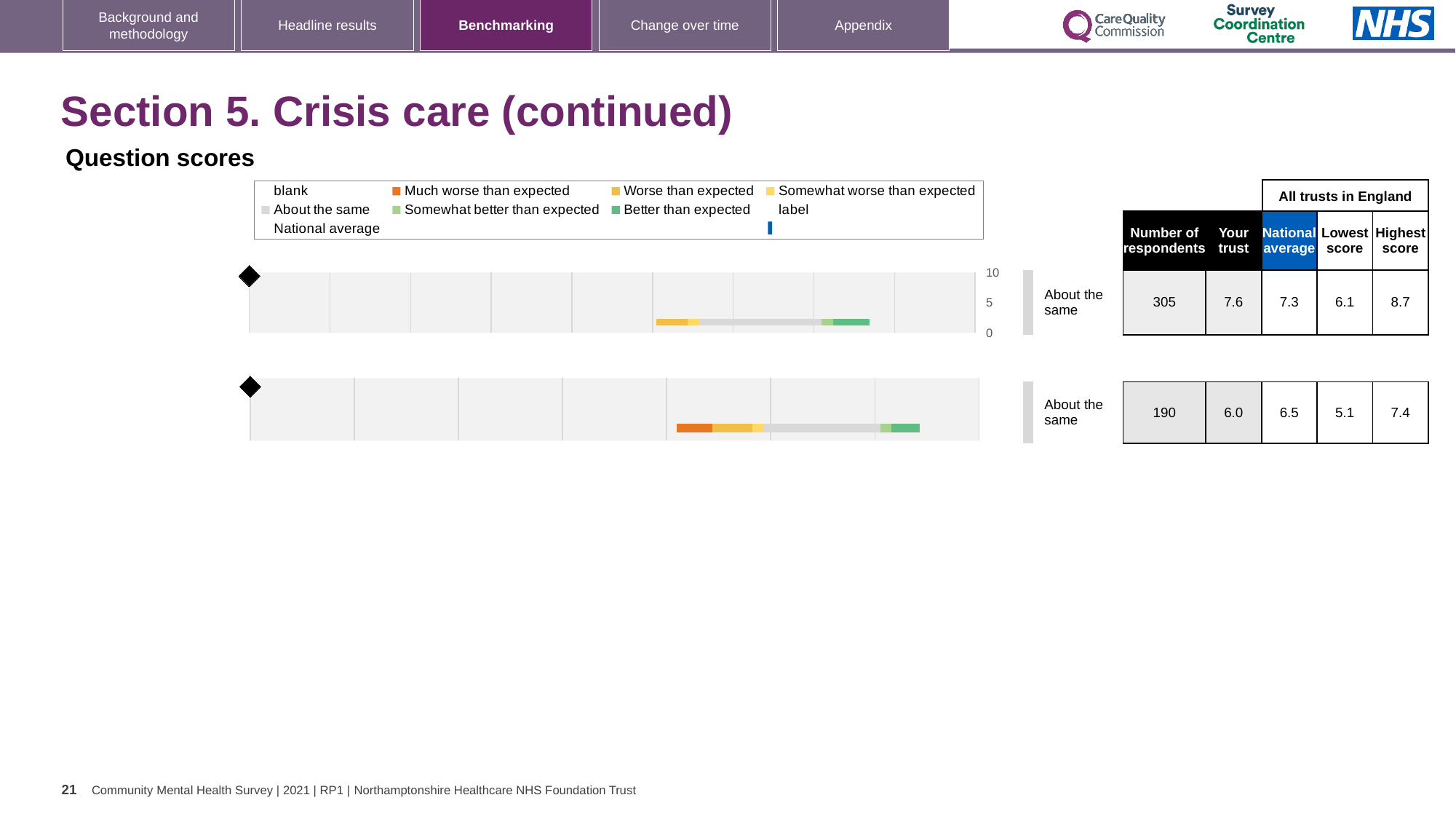
For the top chart, what is the difference between the highest score (8.7) and the lowest score (6.1) across all trusts in England? 2.6 In the table next to the top chart, what is the 'Your trust' score? 7.6 In the table next to the bottom chart, what is the highest score among all trusts in England? 7.4 What is the maximum value shown on the axis of the top chart? 10 What benchmark category is shown beside both the top and bottom charts? About the same What kind of chart is used for the top benchmarking chart on the slide? bar chart How many respondents are listed for the top chart's question? 305 For the bottom chart, is the 'Your trust' score (6.0) larger or smaller than the national average (6.5)? smaller In the table next to the bottom chart, what is the 'Your trust' score? 6.0 How many respondents are listed for the bottom chart's question? 190 In the legend, what colour represents 'Much worse than expected'? orange In the table next to the top chart, what is the national average score? 7.3